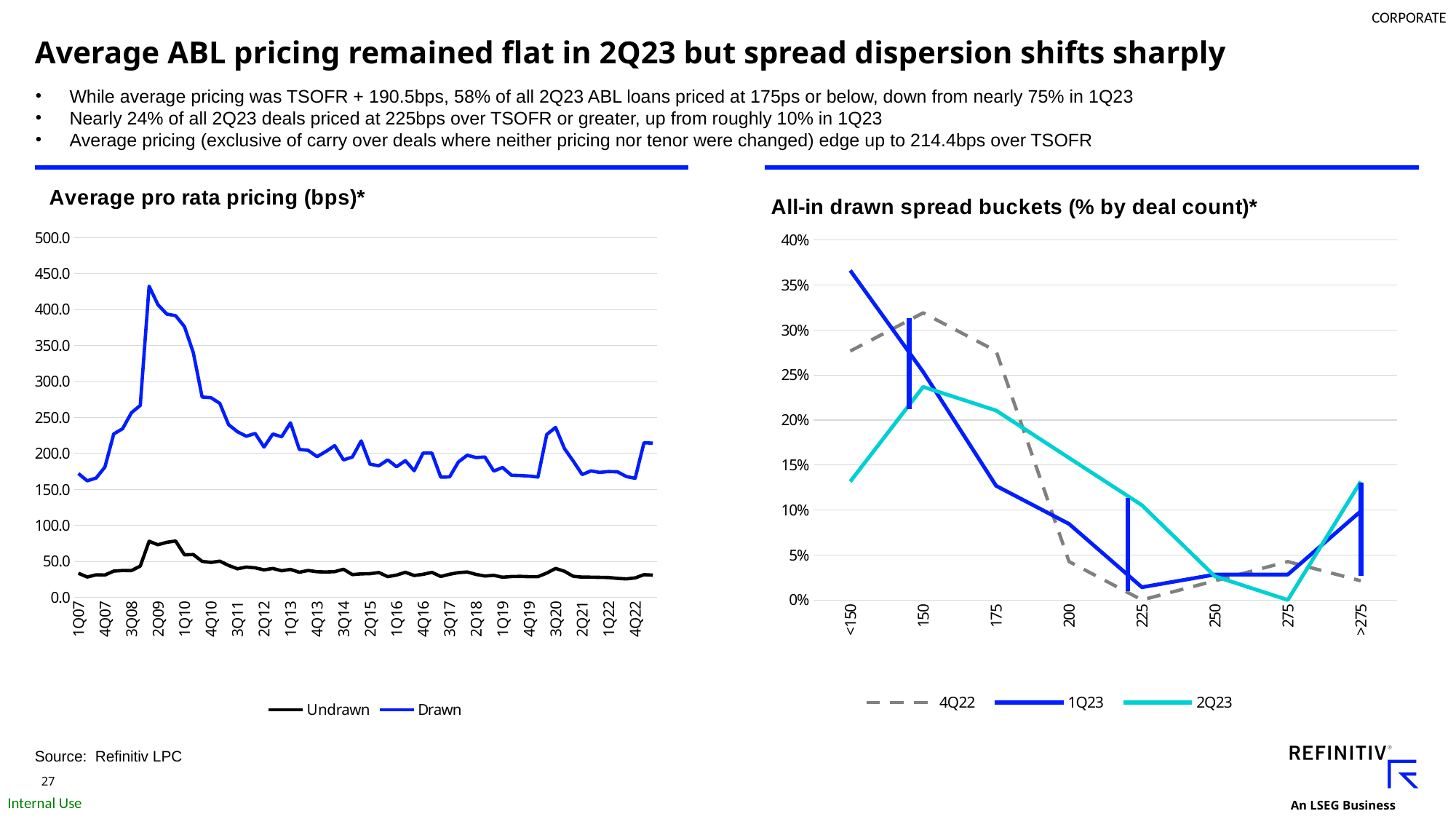
In the 'All-in drawn spread buckets (% by deal count)*' chart, is the 4Q22 value for the 200 bucket greater or less than 5%? less How many spread buckets are shown on the x axis of the 'All-in drawn spread buckets (% by deal count)*' chart? 8 In the 'Average pro rata pricing (bps)*' chart, which series is consistently higher, Undrawn or Drawn? Drawn What kind of chart is the 'Average pro rata pricing (bps)*' chart on the left? line chart In the 'Average pro rata pricing (bps)*' chart, is the peak Drawn value around 2Q09 greater or less than 400.0? greater In the 'All-in drawn spread buckets (% by deal count)*' chart, which bucket has the highest value for 4Q22? 150 How many series does the legend of the 'All-in drawn spread buckets (% by deal count)*' chart list? 3 In the 'All-in drawn spread buckets (% by deal count)*' chart, is the 1Q23 value for the <150 bucket greater or less than 35%? greater In the 'All-in drawn spread buckets (% by deal count)*' chart, which series has the larger value at the 200 bucket, 2Q23 or 4Q22? 2Q23 In the 'All-in drawn spread buckets (% by deal count)*' chart, which series has the larger value at the 175 bucket, 4Q22 or 1Q23? 4Q22 In the 'All-in drawn spread buckets (% by deal count)*' chart, which bucket has the highest value for 1Q23? <150 In the 'All-in drawn spread buckets (% by deal count)*' chart, which bucket has the lowest value for 2Q23? 275